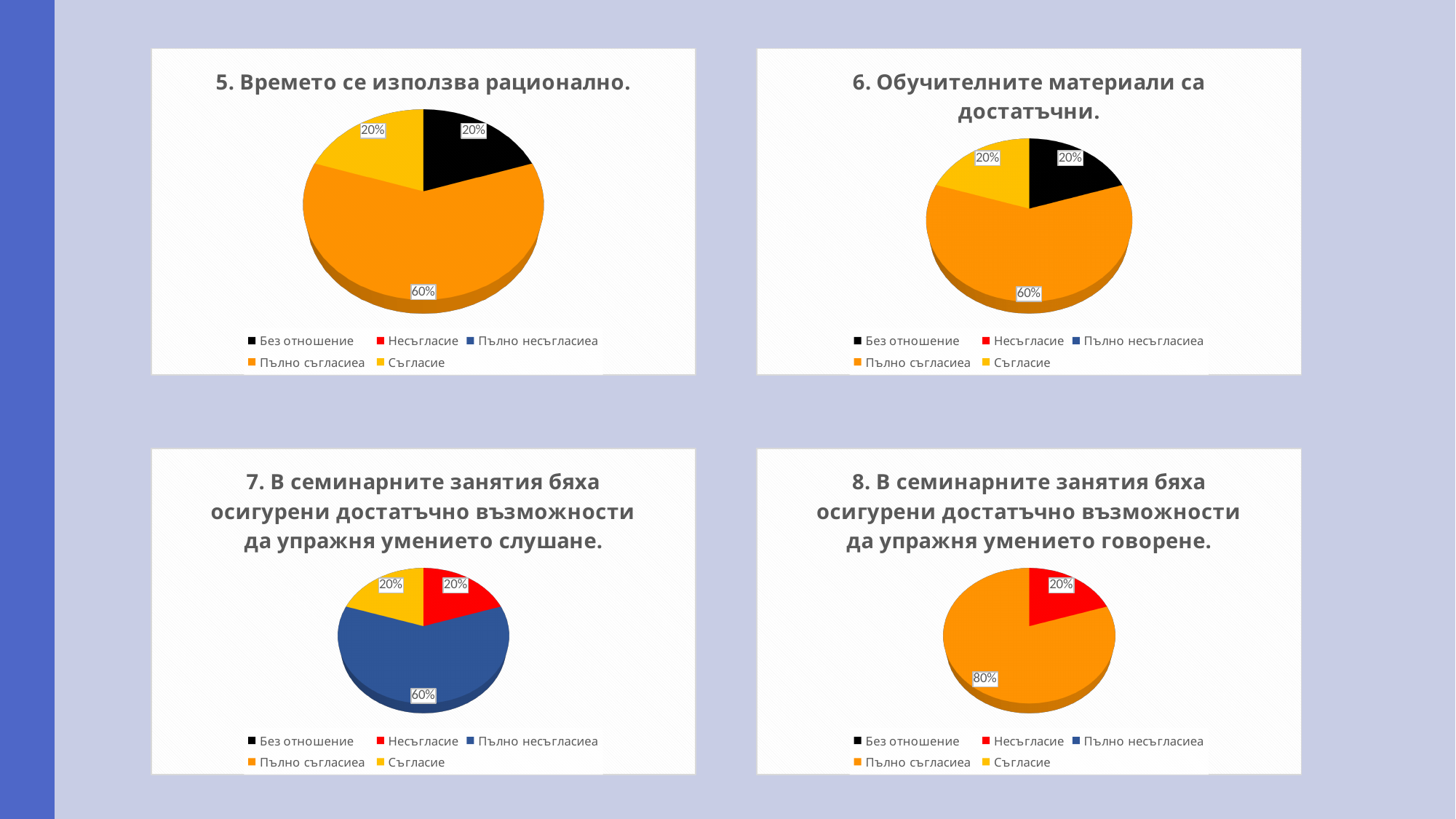
In the chart titled "8. В семинарните занятия бяха осигурени достатъчно възможности да упражня умението говорене.", which is larger, "Несъгласие" or "Пълно съгласиеа"? Пълно съгласиеа How many entries does the legend of the top-left chart list? 5 In the chart titled "6. Обучителните материали са достатъчни.", what is the difference between "Пълно съгласиеа" and "Без отношение"? 40% In the chart titled "8. В семинарните занятия бяха осигурени достатъчно възможности да упражня умението говорене.", what share does "Пълно съгласиеа" have? 80% In the chart titled "5. Времето се използва рационално.", what share does "Пълно съгласиеа" have? 60% In the chart titled "7. В семинарните занятия бяха осигурени достатъчно възможности да упражня умението слушане.", what is the value for "Несъгласие"? 20% In the chart titled "5. Времето се използва рационално.", which category has the largest slice? Пълно съгласиеа In the chart titled "5. Времето се използва рационално.", what is the value for "Без отношение"? 20% What type of chart is the bottom-left chart on the slide? Pie chart In the chart titled "6. Обучителните материали са достатъчни.", what is the value for "Съгласие"? 20% In the chart titled "8. В семинарните занятия бяха осигурени достатъчно възможности да упражня умението говорене.", how many slices does the pie have? 2 In the chart titled "7. В семинарните занятия бяха осигурени достатъчно възможности да упражня умението слушане.", which category has the largest slice? Пълно несъгласиеа